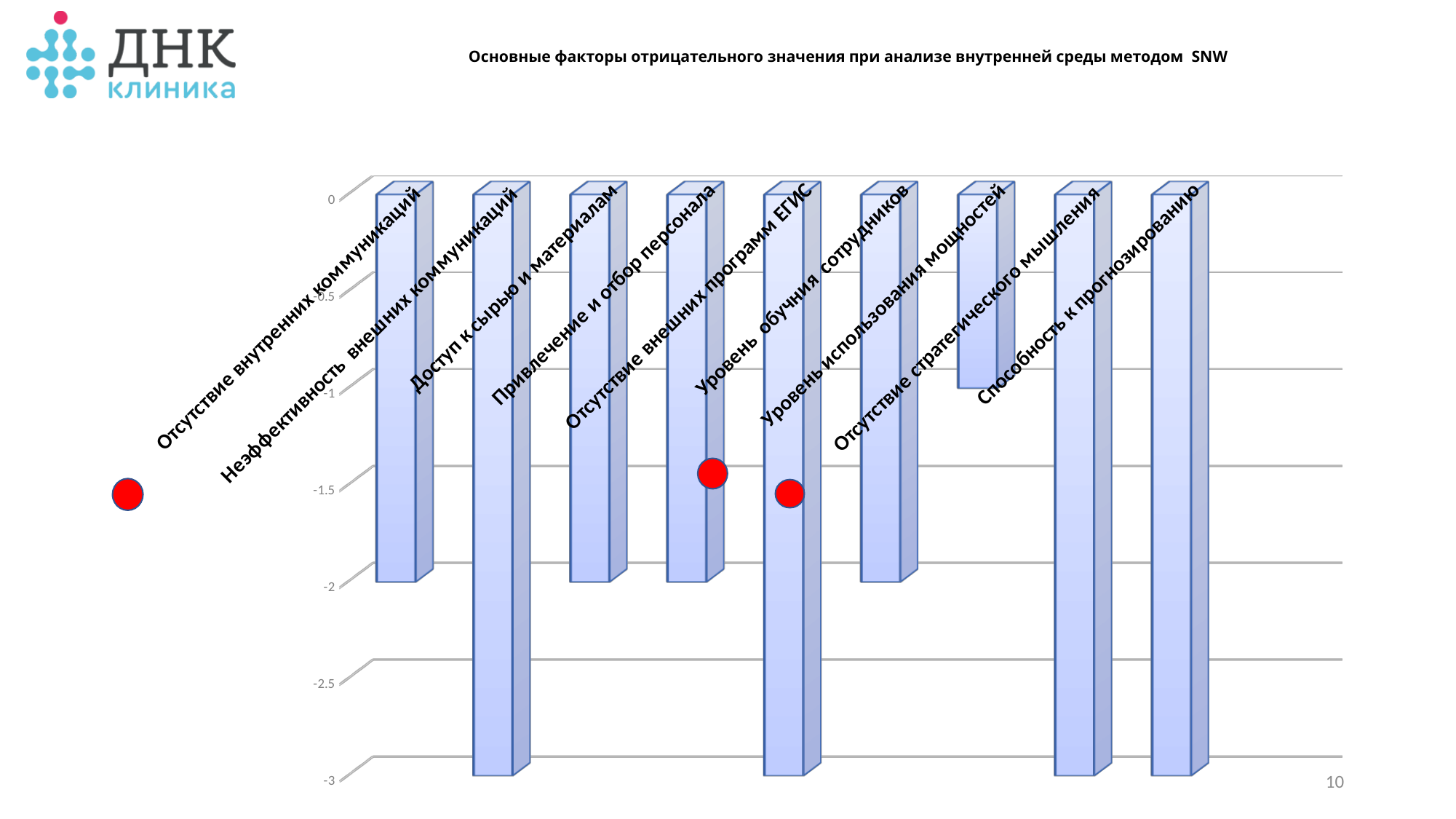
What is the value for "Отсутствие внутренних коммуникаций"? -2 How many categories (factors) are plotted in the chart? 9 What is the difference between the value for "Уровень использования мощностей" and the value for "Отсутствие внешних программ ЕГИС"? 2 What is the value for "Уровень использования мощностей"? -1 What is the title of the chart on the slide? Основные факторы отрицательного значения при анализе внутренней среды методом SNW What is the value for "Неэффективность внешних коммуникаций"? -3 What kind of chart is shown on the slide? Bar chart Which is larger, the value for "Уровень использования мощностей" or the value for "Отсутствие стратегического мышления"? Уровень использования мощностей What is the value for "Способность к прогнозированию"? -3 What is the value for "Уровень обучения сотрудников"? -2 Which category has the highest (least negative) value? Уровень использования мощностей Is the value for "Уровень использования мощностей" greater or less than -2? greater